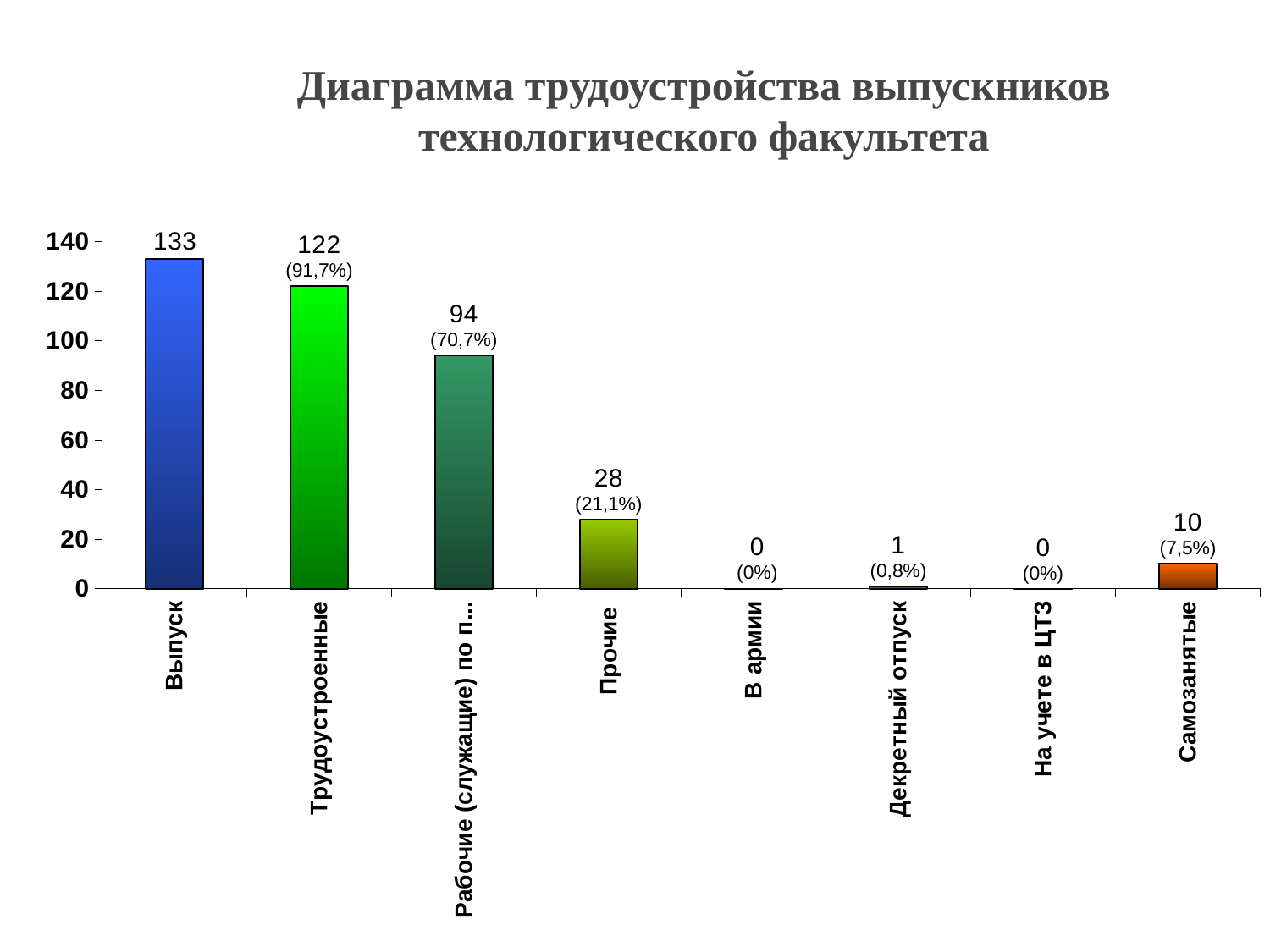
Which is larger, the value for Прочие or the value for Самозанятые? Прочие What is the difference between the values for Выпуск and Трудоустроенные? 11 What is the title of the chart? Диаграмма трудоустройства выпускников технологического факультета What percentage is shown for Трудоустроенные? 91,7% What is the value for Самозанятые? 10 What is the value for Прочие? 28 Which category has the highest value? Выпуск What is the value for Декретный отпуск? 1 What type of chart is shown on the slide? bar chart What is the value for Выпуск? 133 How many categories are shown on the x axis? 8 What is the value for Трудоустроенные? 122